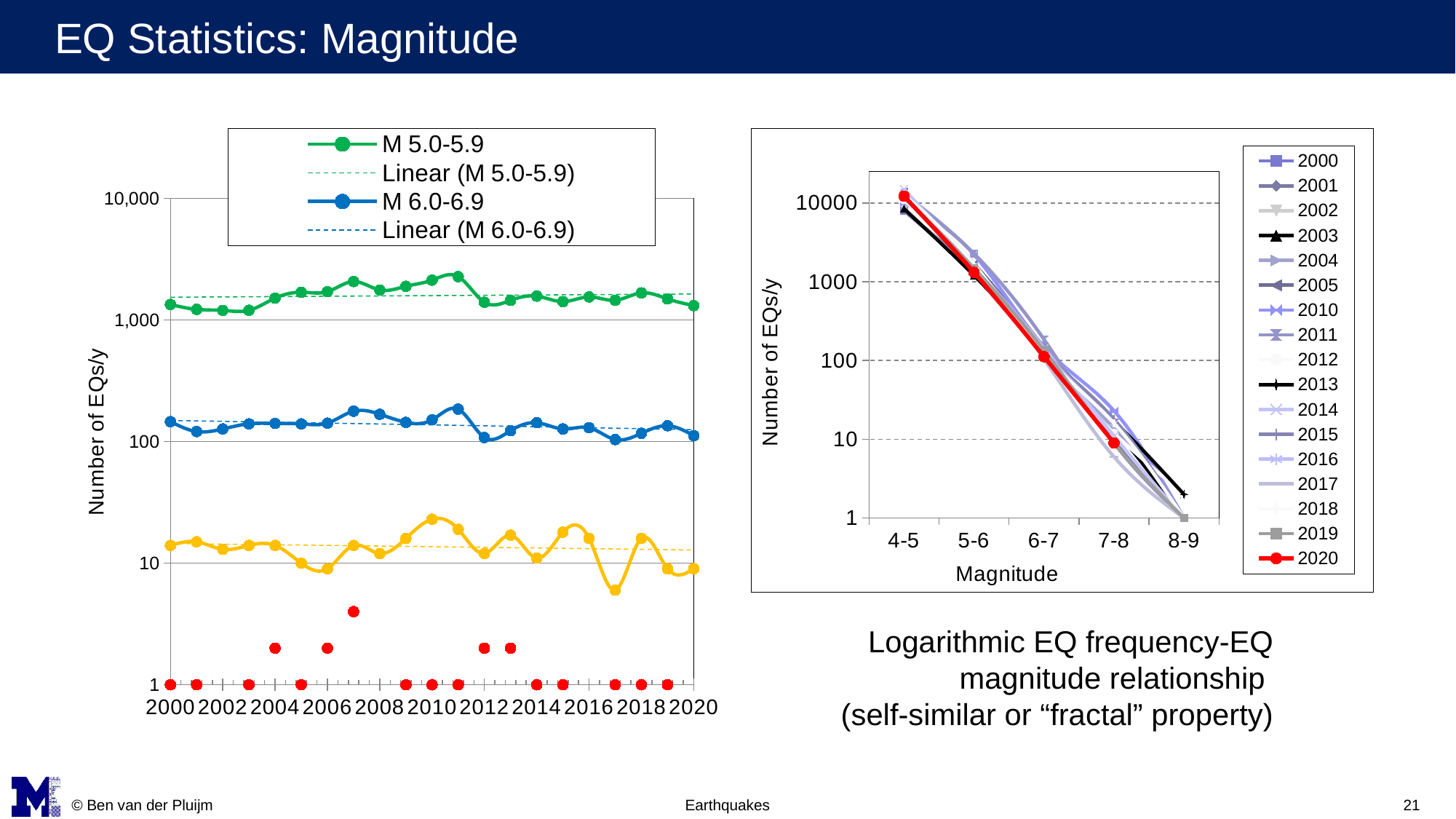
How many entries does the legend of the left chart list? 4 In the left chart, is the value for M 5.0-5.9 in 2000 greater or less than 1,000? greater In the right chart, how many magnitude categories are shown on the x axis? 5 In the left chart, which series has the larger value in 2010, M 5.0-5.9 or M 6.0-6.9? M 5.0-5.9 In the right chart, is the value for 2020 at magnitude 5-6 greater or less than 1000? greater How many series does the legend of the right chart list? 17 In the right chart, do the values rise or fall as magnitude increases? fall In the left chart, in which year does the M 5.0-5.9 series reach its highest value? 2011 What is the y-axis label of the left chart? Number of EQs/y In the left chart, is the value for M 6.0-6.9 in 2000 greater or less than 100? greater What is the x-axis label of the right chart? Magnitude What kind of chart is the chart on the left of the slide? line chart